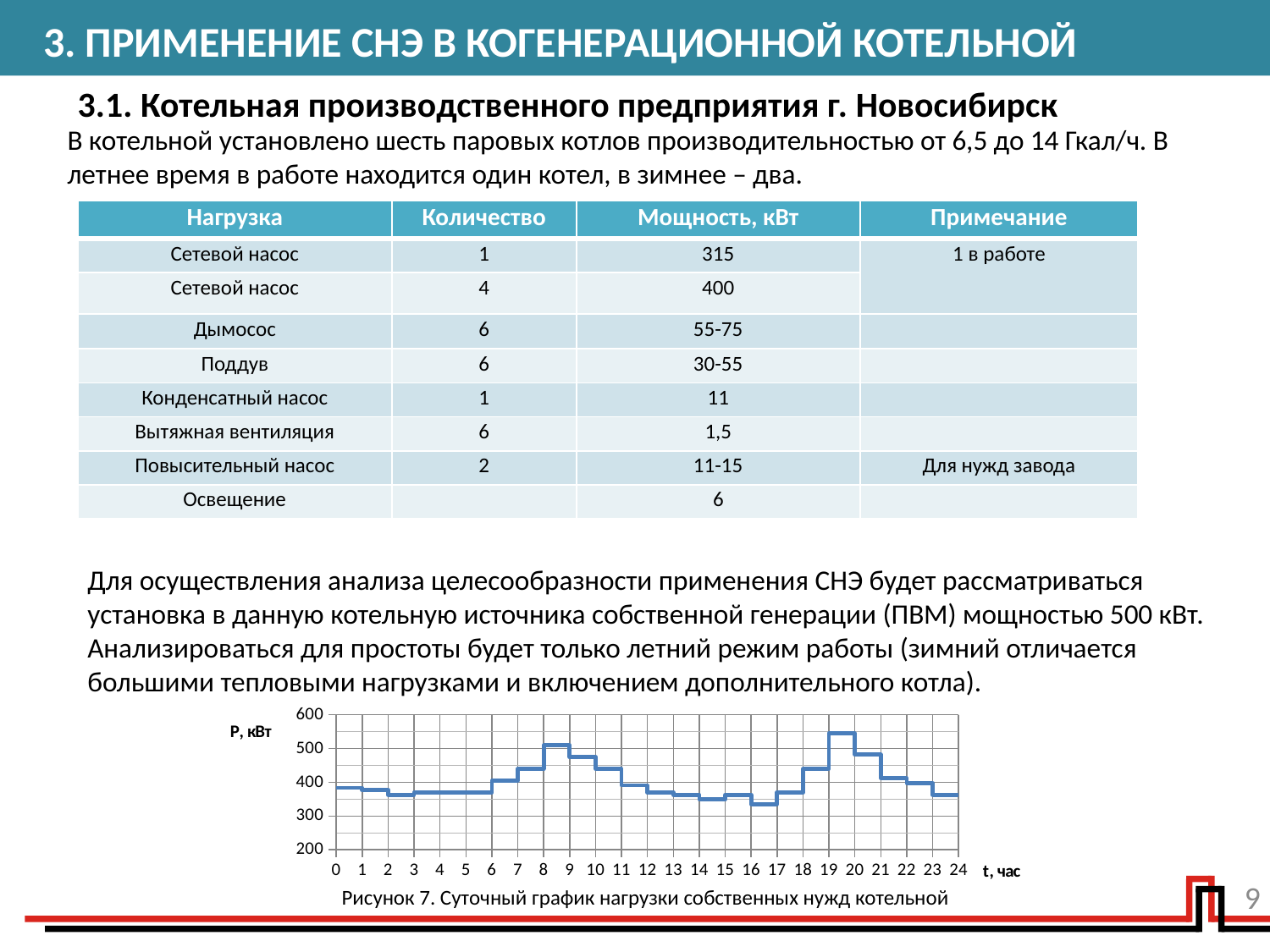
In the chart Рисунок 7, at which hour does the load reach its highest value? 19 In the chart Рисунок 7, is the value at hour 2 greater or less than 400? less In the chart Рисунок 7, which is larger: the value at hour 16 or the value at hour 10? hour 10 In the chart Рисунок 7, is the value at hour 19 greater or less than 500? greater In the chart Рисунок 7, is the value at hour 20 greater or less than 400? greater What is the label of the vertical axis in the chart Рисунок 7? P, кВт What kind of chart is shown at the bottom of the slide (Рисунок 7)? line chart In the chart Рисунок 7, do the values rise or fall between hour 16 and hour 19? rise In the chart Рисунок 7, which is larger: the value at hour 19 or the value at hour 8? hour 19 In the chart Рисунок 7, do the values rise or fall between hour 19 and hour 24? fall